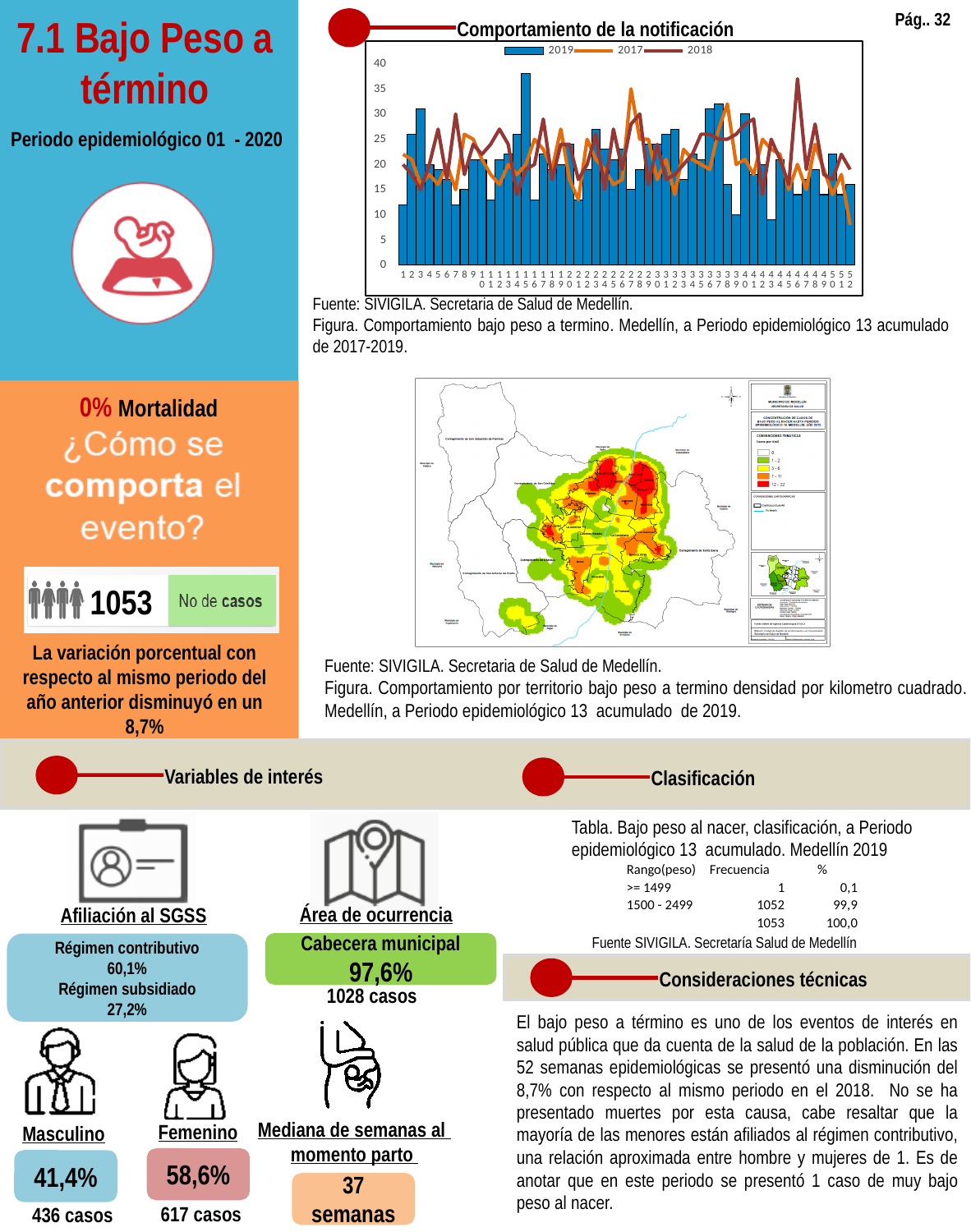
Which years are listed in the legend of the 'Comportamiento de la notificación' chart? 2019, 2017 and 2018 How many epidemiological weeks are shown on the x axis of the 'Comportamiento de la notificación' chart? 52 In the 'Comportamiento de la notificación' chart, which is larger for 2019: the bar for week 15 or the bar for week 1? week 15 What is the highest value shown on the y axis of the 'Comportamiento de la notificación' chart? 40 In the 'Comportamiento de la notificación' chart, is the 2019 value for week 1 greater or less than 15? less In the 'Comportamiento de la notificación' chart, which series is drawn as bars? 2019 How many series does the legend of the 'Comportamiento de la notificación' chart list? 3 In the 'Comportamiento de la notificación' chart, which week has the highest 2019 bar? 15 In the 'Comportamiento de la notificación' chart, is the 2019 value for week 2 greater or less than 20? greater What kind of chart is used for the 2019 series in the 'Comportamiento de la notificación' chart? bar chart In the 'Comportamiento de la notificación' chart, is the 2019 value for week 15 greater or less than 35? greater